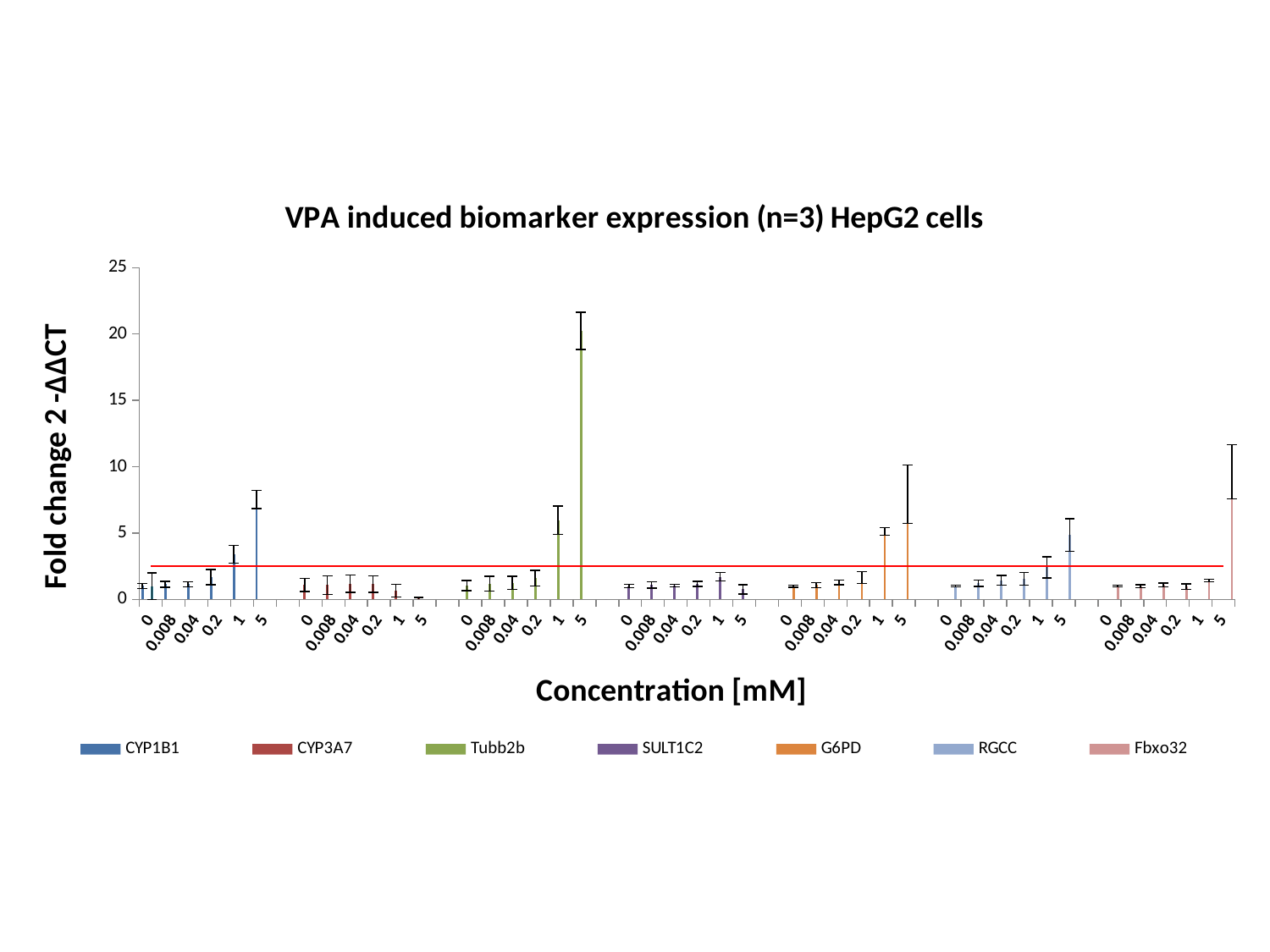
Is the value for CYP1B1 at 5 mM greater or less than 5? greater Which is larger: the value for Tubb2b at 5 mM or the value for CYP1B1 at 5 mM? Tubb2b at 5 mM Is the value for CYP3A7 at 5 mM greater or less than 5? less Which series has the tallest bar in the chart? Tubb2b Is the value for RGCC at 5 mM greater or less than 5? less What is the label of the x axis? Concentration [mM] What is the title of the chart? VPA induced biomarker expression (n=3) HepG2 cells How many concentration levels are plotted for each series? 6 How many series does the legend list? 7 What kind of chart is shown on the slide? bar chart